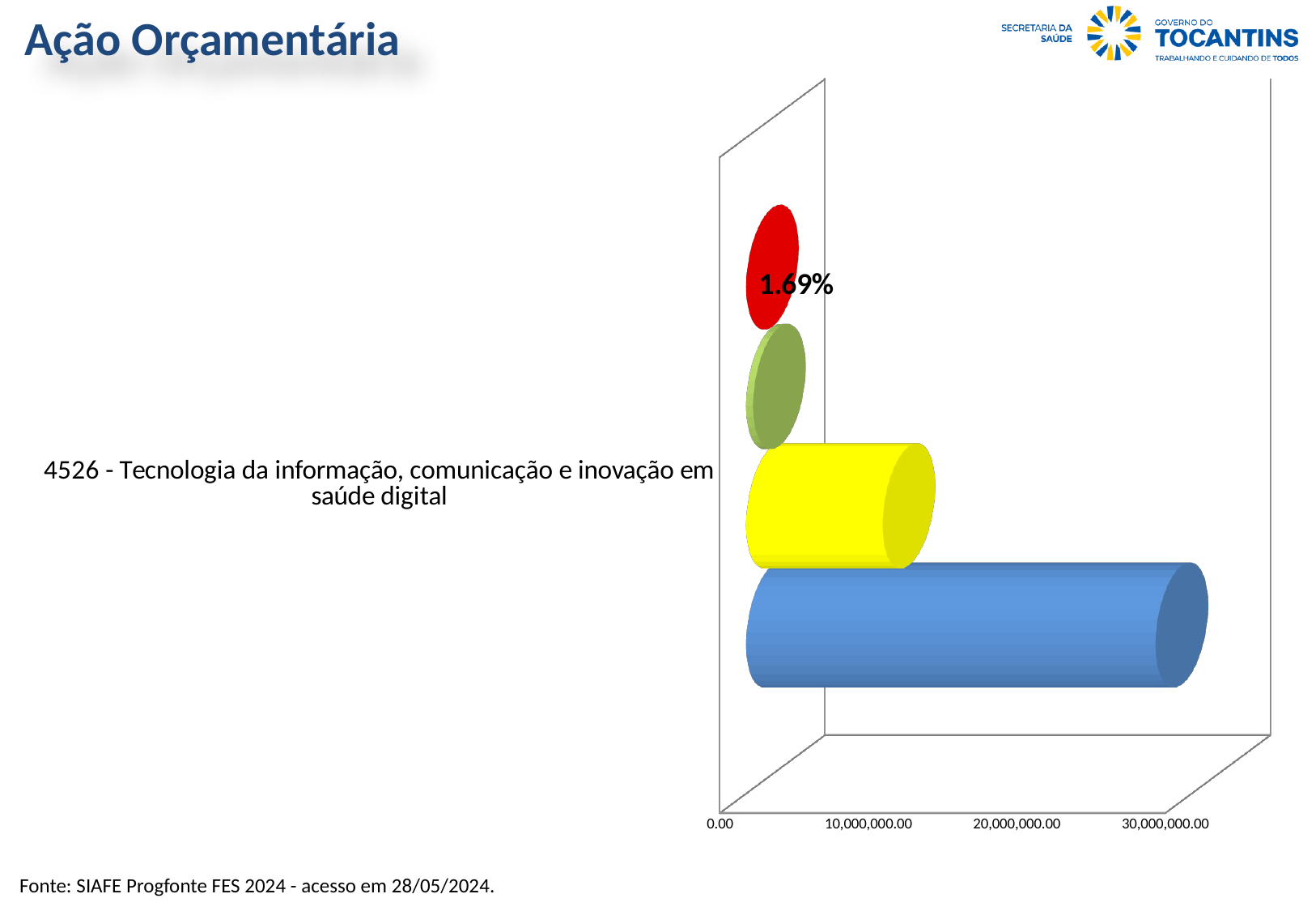
Which colour bar is the longest in the chart? blue How many bars are plotted in the chart? 4 Which is larger, the blue bar or the yellow bar? the blue bar What is the category label shown on the chart? 4526 - Tecnologia da informação, comunicação e inovação em saúde digital What percentage value is printed as a data label on the red bar? 1.69% Is the value of the blue bar greater or less than 20,000,000.00? greater What kind of chart is shown on the slide? bar chart What is the highest tick value shown on the horizontal axis? 30,000,000.00 Is the value of the red bar greater or less than 10,000,000.00? less Is the value of the green bar greater or less than 10,000,000.00? less How many categories are shown on the vertical axis of the chart? 1